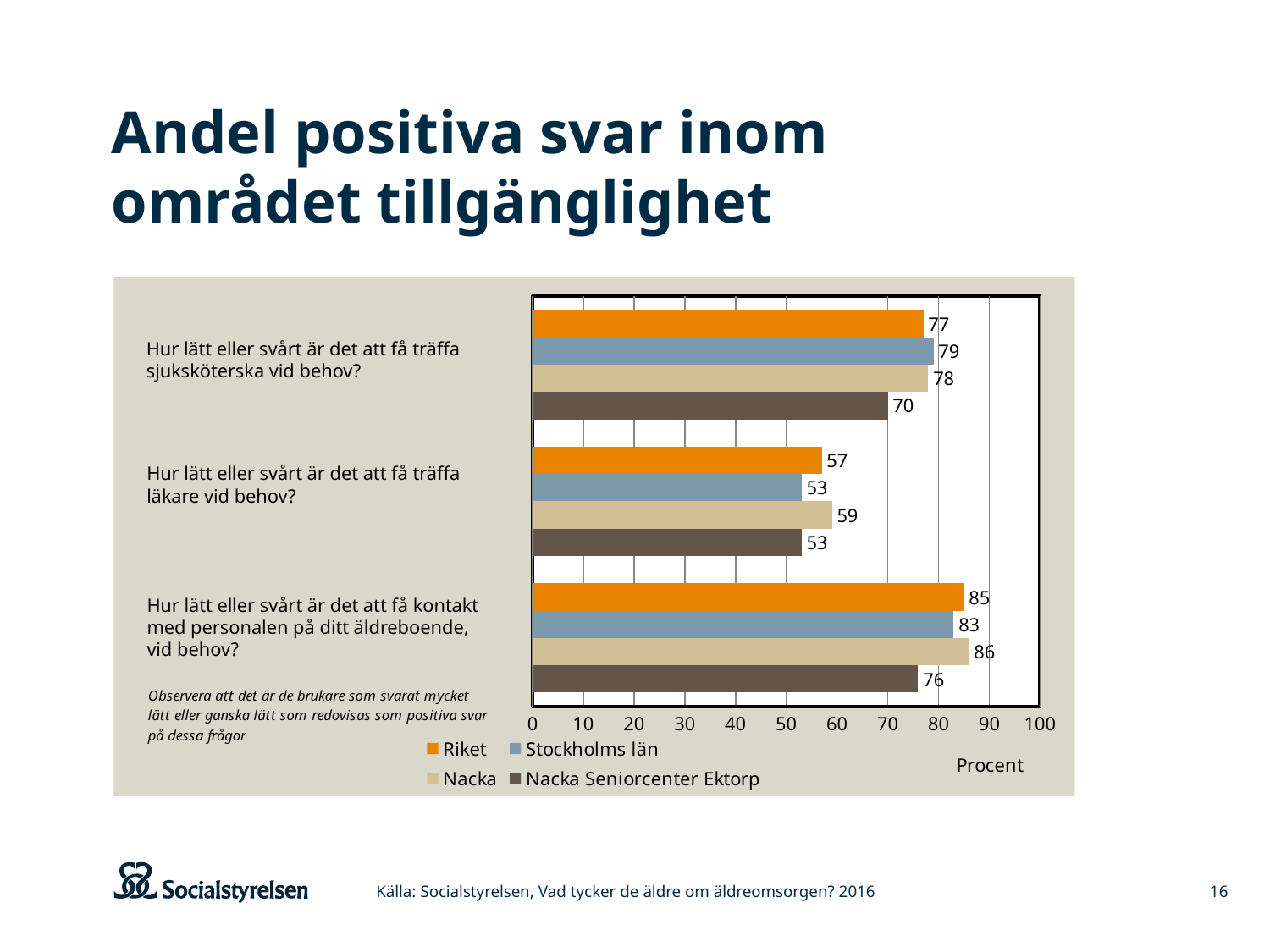
How many question categories are shown on the chart? 3 What is the value for Stockholms län on the question "Hur lätt eller svårt är det att få träffa sjuksköterska vid behov?"? 79 Which series has the lowest value on the question "Hur lätt eller svårt är det att få kontakt med personalen på ditt äldreboende, vid behov?"? Nacka Seniorcenter Ektorp Which series has the highest value on the question "Hur lätt eller svårt är det att få träffa läkare vid behov?"? Nacka What is the value for Nacka Seniorcenter Ektorp on the question "Hur lätt eller svårt är det att få träffa sjuksköterska vid behov?"? 70 What is the value for Nacka on the question "Hur lätt eller svårt är det att få kontakt med personalen på ditt äldreboende, vid behov?"? 86 Which is larger on the question "Hur lätt eller svårt är det att få träffa sjuksköterska vid behov?": Riket or Nacka Seniorcenter Ektorp? Riket What is the value for Riket on the question "Hur lätt eller svårt är det att få träffa läkare vid behov?"? 57 What kind of chart is shown on the slide? Bar chart How many series does the legend list? 4 What is the label on the horizontal axis of the chart? Procent What is the difference between Nacka and Nacka Seniorcenter Ektorp on the question "Hur lätt eller svårt är det att få kontakt med personalen på ditt äldreboende, vid behov?"? 10